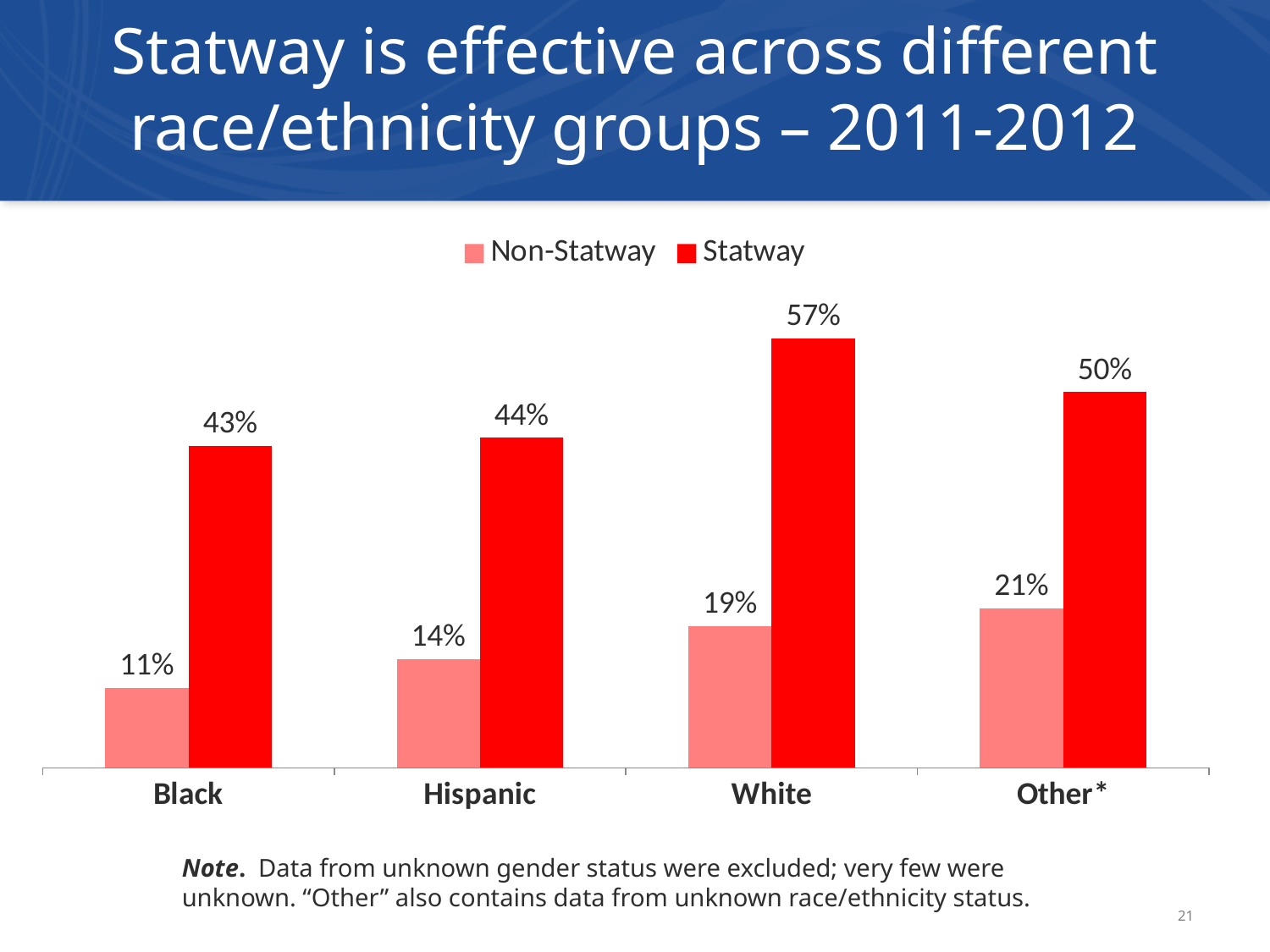
What is the Statway value for White? 57% What is the difference between the Statway and Non-Statway values for Black? 32% What is the difference between the Statway values for White and Hispanic? 13% Which is larger, the Statway value for Other* or the Statway value for Hispanic? Other* What is the Non-Statway value for Hispanic? 14% Which colour represents the Statway series in the legend? Red What kind of chart is shown on the slide? Bar chart What is the Non-Statway value for Other*? 21% Which race/ethnicity group has the highest Statway value? White How many race/ethnicity groups are shown on the x axis? 4 How many series does the legend list? 2 Which race/ethnicity group has the lowest Non-Statway value? Black